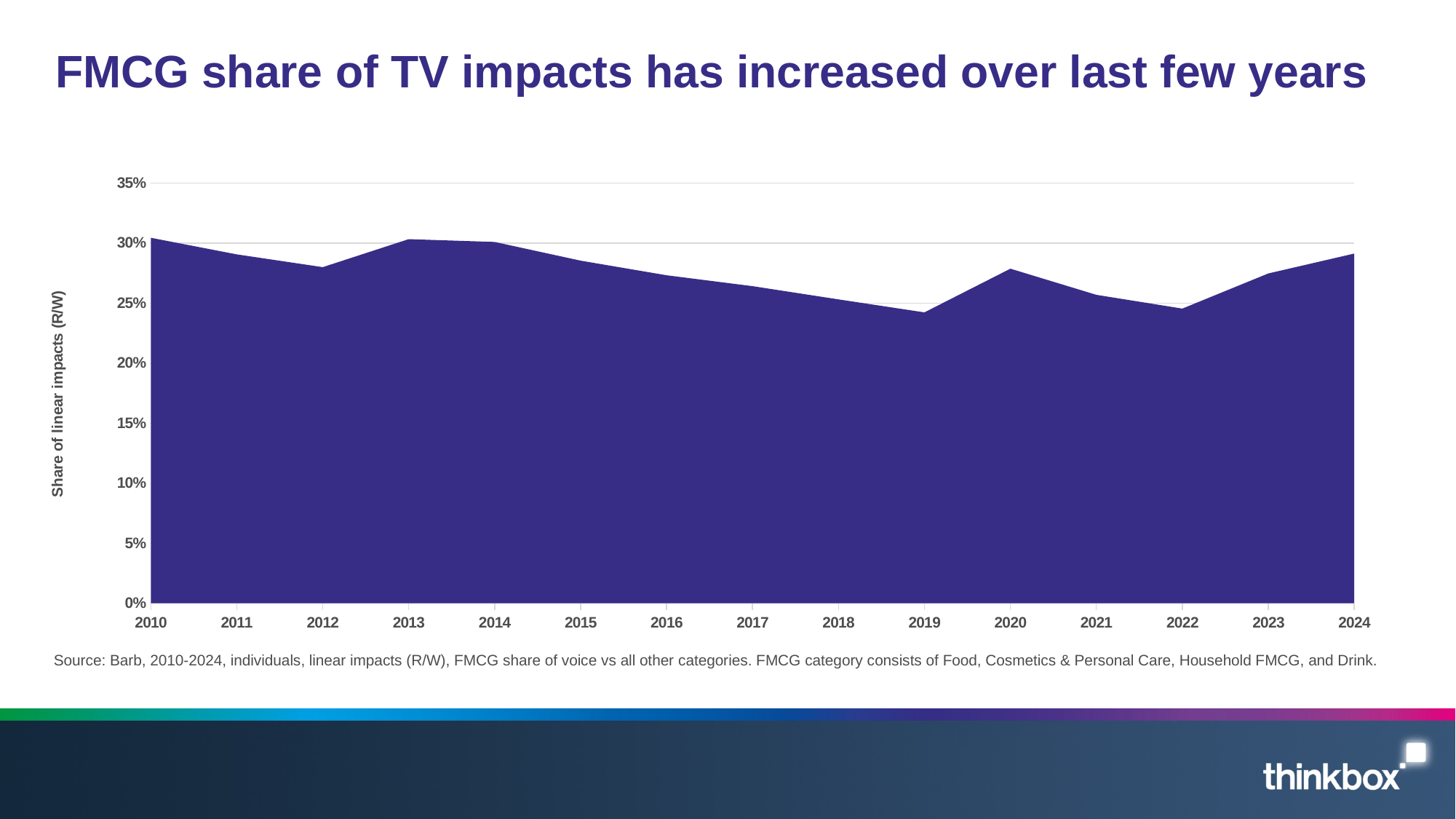
Which year has the larger share, 2014 or 2018? 2014 Which year has the larger share, 2019 or 2020? 2020 Is the value for 2024 greater or less than 30%? less Is the value for 2012 greater or less than 30%? less Which year has the larger share, 2022 or 2024? 2024 Does the share rise or fall between 2014 and 2019? Fall What kind of chart is shown on the slide? Area chart Is the value for 2016 greater or less than 25%? greater What is the label on the vertical axis of the chart? Share of linear impacts (R/W) How many years are plotted along the x axis of the chart? 15